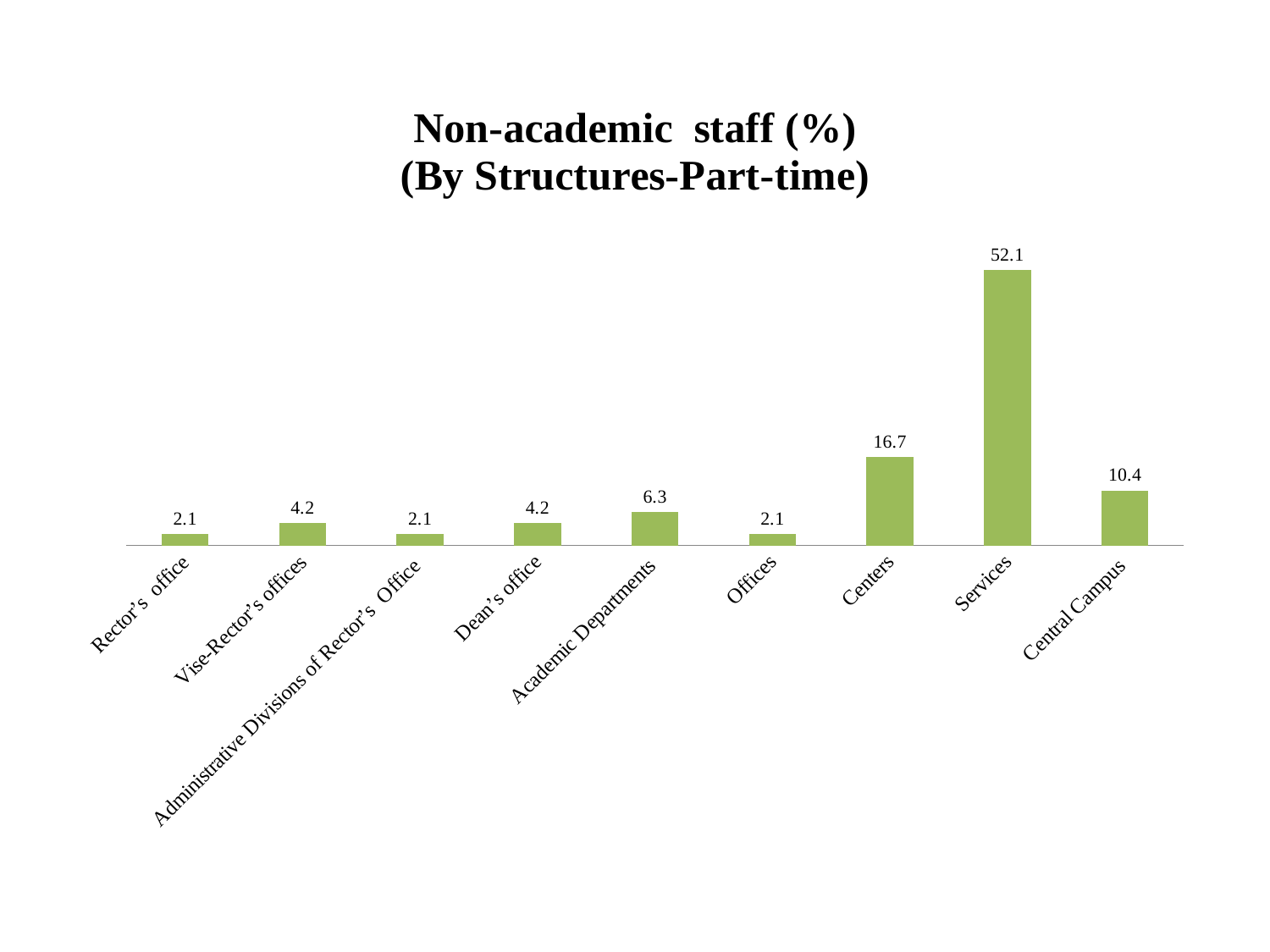
What is the value for Centers? 16.7 What is the value for Central Campus? 10.4 Which is larger, the value for Dean's office or the value for Academic Departments? Academic Departments Which is larger, the value for Centers or the value for Central Campus? Centers What is the value for Services? 52.1 What kind of chart is shown on the slide? Bar chart How many categories are shown on the x axis? 9 What is the difference between the values for Central Campus and Academic Departments? 4.1 What is the difference between the values for Services and Centers? 35.4 What is the title of the chart? Non-academic staff (%) (By Structures-Part-time) What is the value for Academic Departments? 6.3 Which category has the highest value? Services